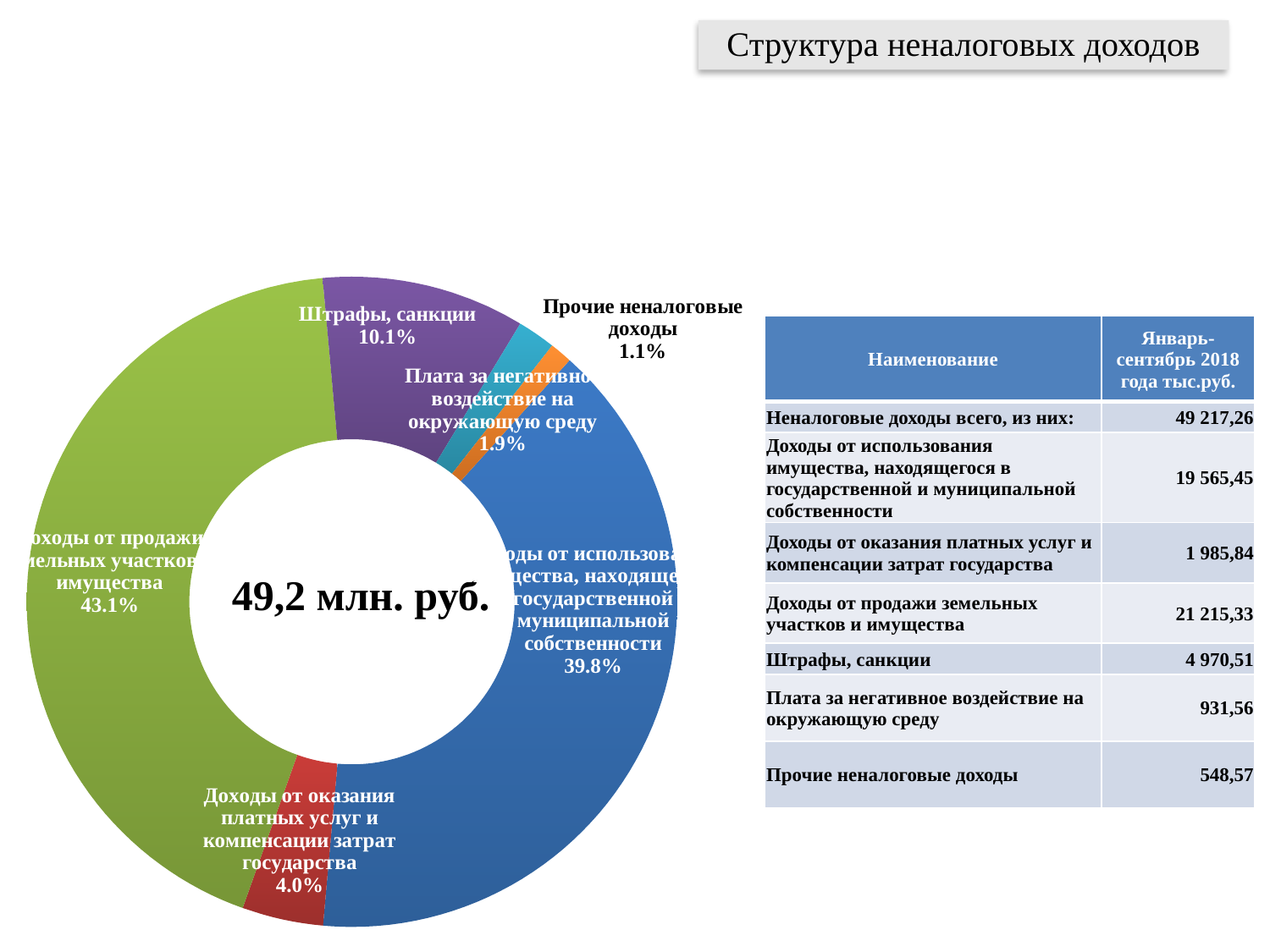
Which category has the largest share in the chart? Доходы от продажи земельных участков и имущества (43.1%) What type of chart is shown on the slide? doughnut (pie) chart How many categories (slices) does the chart show? 6 Which is larger: the share for "Штрафы, санкции" or the share for "Доходы от оказания платных услуг и компенсации затрат государства"? Штрафы, санкции What total value is printed in the centre of the doughnut chart? 49,2 млн. руб. What is the difference in percentage points between the share for "Доходы от продажи земельных участков и имущества" and the share for income from use of state and municipal property (39.8%)? 3.3 percentage points Which category has the smallest share in the chart? Прочие неналоговые доходы (1.1%) What percentage is labelled for "Плата за негативное воздействие на окружающую среду"? 1.9% What share is shown for "Доходы от оказания платных услуг и компенсации затрат государства"? 4.0% What share of the chart does "Штрафы, санкции" represent? 10.1% What share is shown for "Прочие неналоговые доходы"? 1.1% What is the title shown at the top of the slide? Структура неналоговых доходов